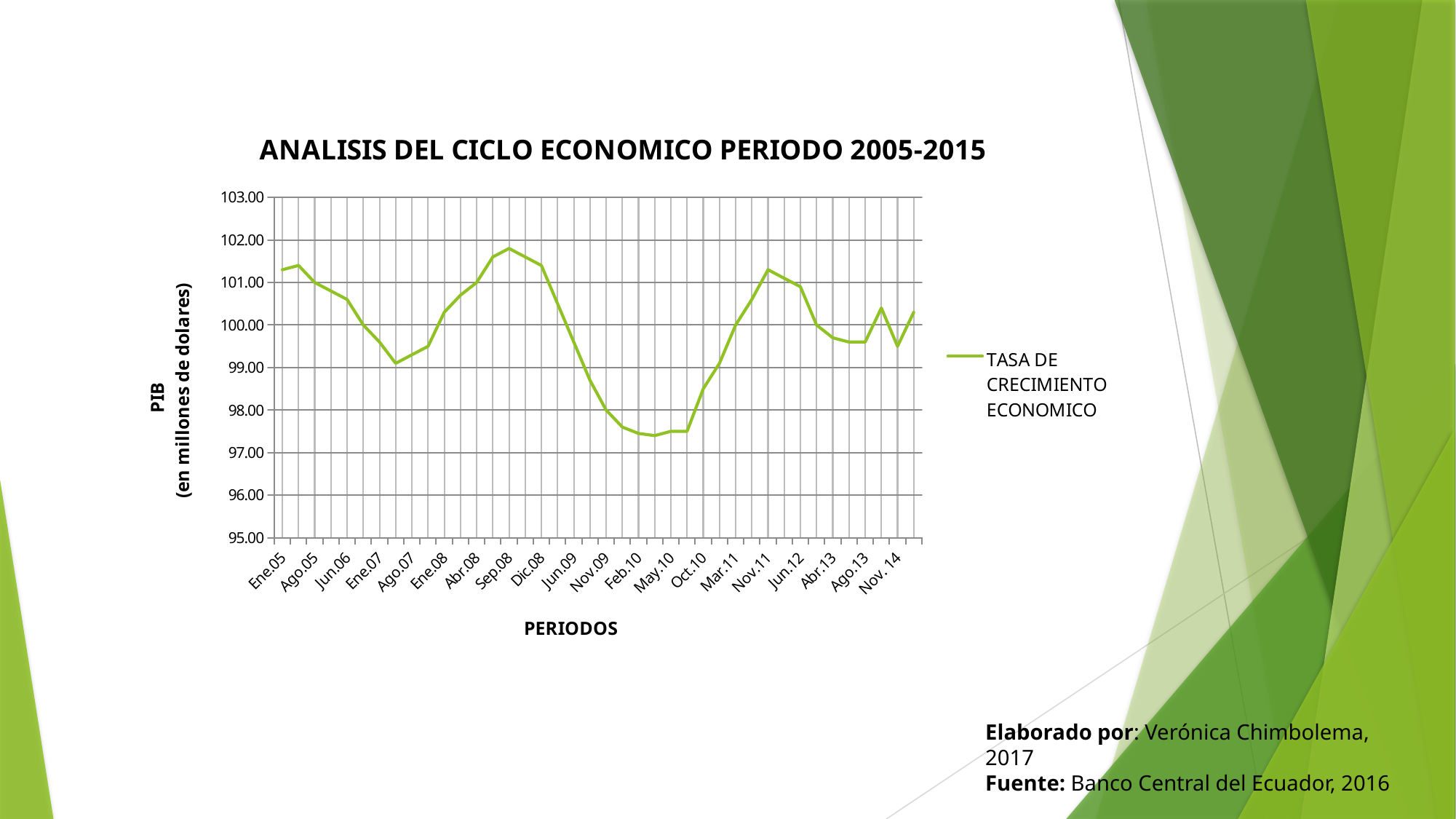
Does the line rise or fall between Sep.08 and Feb.10? fall Which is larger, the value for Sep.08 or the value for Feb.10? Sep.08 What kind of chart is shown on the slide? line chart Is the value for Sep.08 greater or less than 101.00? greater What is the name of the series shown in the legend? TASA DE CRECIMIENTO ECONOMICO Is the value for Feb.10 greater or less than 98.00? less Does the line rise or fall between May.10 and Nov.11? rise At which labelled period does the line reach its highest value? Sep.08 What is the title of the chart? ANALISIS DEL CICLO ECONOMICO PERIODO 2005-2015 Is the value for Ene.05 greater or less than 100.00? greater How many series does the legend list? 1